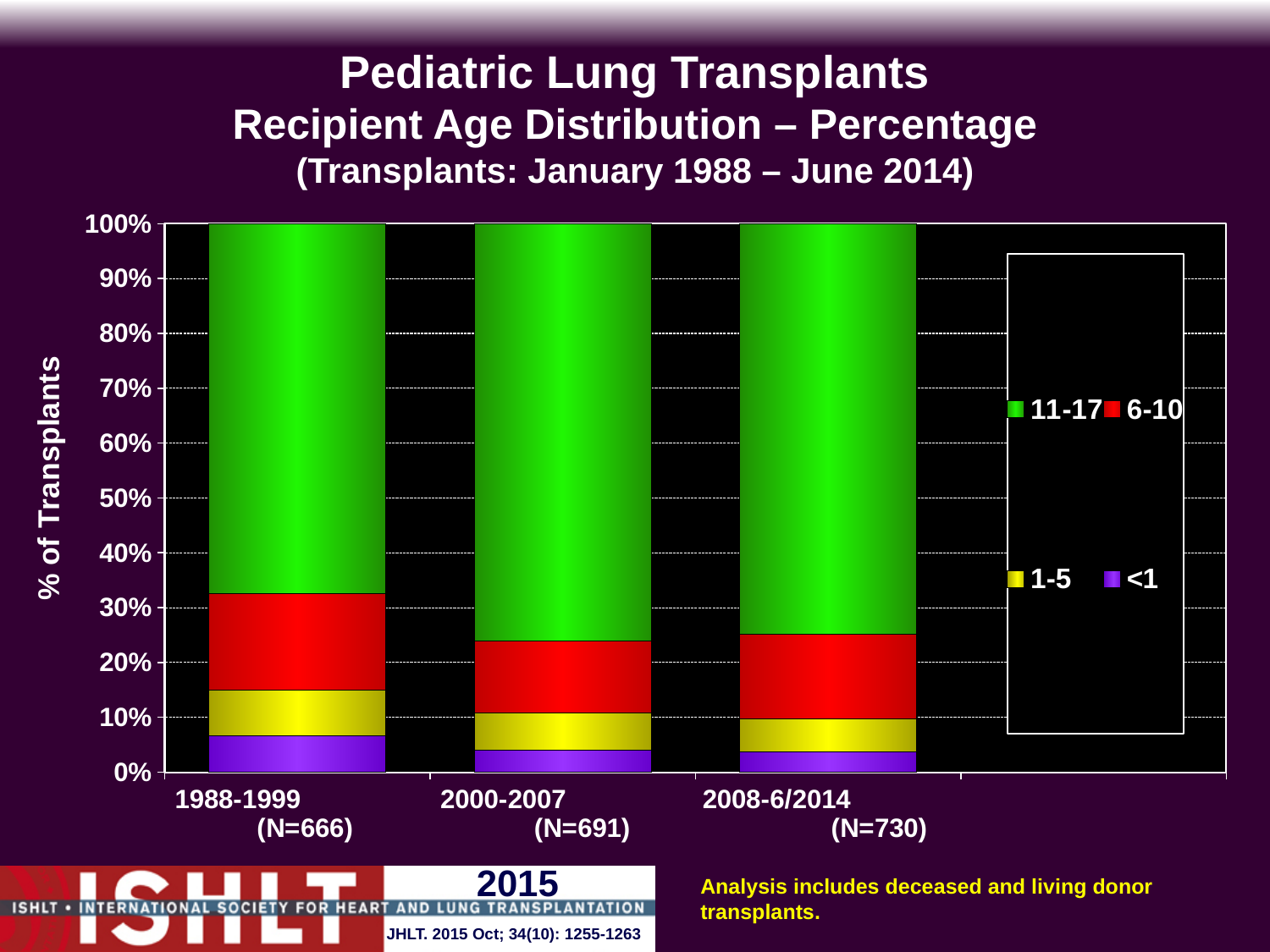
How many time-period categories are shown on the x axis? 3 Is the share of <1 year old recipients in 1988-1999 greater or less than 10%? less What is the number of transplants (N) for the 2008-6/2014 period? N=730 What is the label of the y axis? % of Transplants Which period has the larger share of <1 year old recipients, 1988-1999 or 2008-6/2014? 1988-1999 What kind of chart is shown on the slide? Stacked bar chart Is the share of 6-10 year old recipients in 1988-1999 greater or less than 10%? greater How many age-group series does the legend list? 4 Does the share of <1 year old recipients rise or fall across the three periods from 1988-1999 to 2008-6/2014? fall Which period has the larger share of 11-17 year old recipients, 1988-1999 or 2000-2007? 2000-2007 Is the share of 11-17 year old recipients in 1988-1999 greater or less than 60%? greater